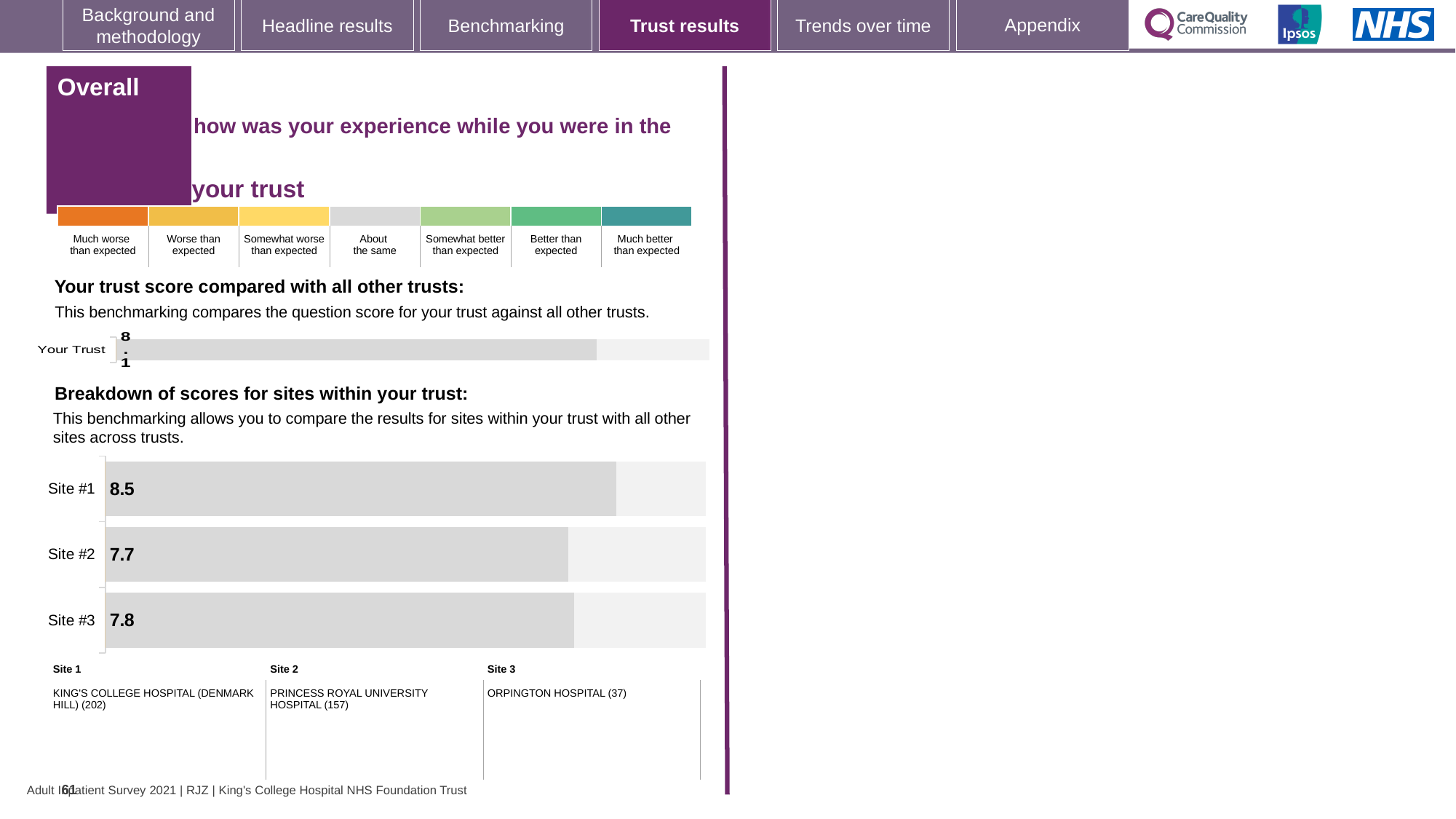
In the 'Breakdown of scores for sites within your trust' chart, what is the difference between the scores for Site #1 and Site #2? 0.8 In the 'Breakdown of scores for sites within your trust' chart, what is the score for Site #3? 7.8 Which hospital is listed as Site 3 below the 'Breakdown of scores for sites within your trust' chart? ORPINGTON HOSPITAL (37) In the 'Breakdown of scores for sites within your trust' chart, what is the difference between the scores for Site #3 and Site #2? 0.1 In the 'Your trust score compared with all other trusts' chart, what is the score for Your Trust? 8.1 In the 'Breakdown of scores for sites within your trust' chart, which has the higher score, Site #2 or Site #3? Site #3 In the 'Breakdown of scores for sites within your trust' chart, what is the score for Site #1? 8.5 How many sites are shown in the 'Breakdown of scores for sites within your trust' chart? 3 What kind of chart is the 'Breakdown of scores for sites within your trust' chart? Bar chart In the 'Breakdown of scores for sites within your trust' chart, which site has the highest score? Site #1 In the 'Breakdown of scores for sites within your trust' chart, which site has the lowest score? Site #2 In the 'Breakdown of scores for sites within your trust' chart, what is the score for Site #2? 7.7